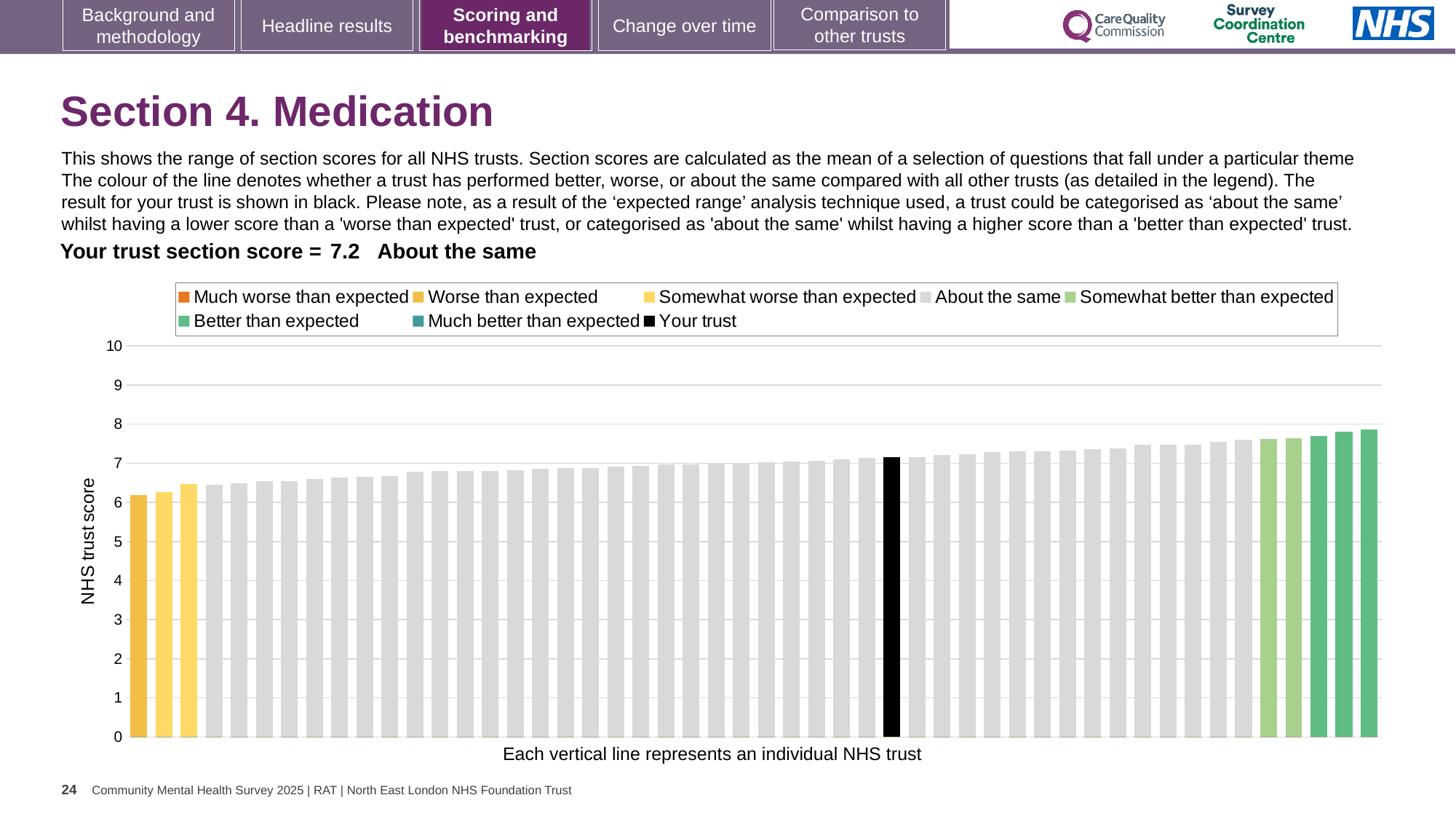
Is the value of the black 'Your trust' bar greater or less than 7? greater Which is larger: the value of the black 'Your trust' bar or the value of the leftmost bar? the black 'Your trust' bar Which category is your trust placed in for the Medication section? About the same What kind of chart is shown on the slide? bar chart Is the value of the rightmost (highest) bar greater or less than 8? less How many entries does the chart legend list? 8 What colour is the bar representing your trust? black Do the bar values rise or fall from left to right across the chart? rise What is the label on the vertical axis of the chart? NHS trust score Is the value of the leftmost bar greater or less than 6? greater What is the section score for your trust shown on the slide? 7.2